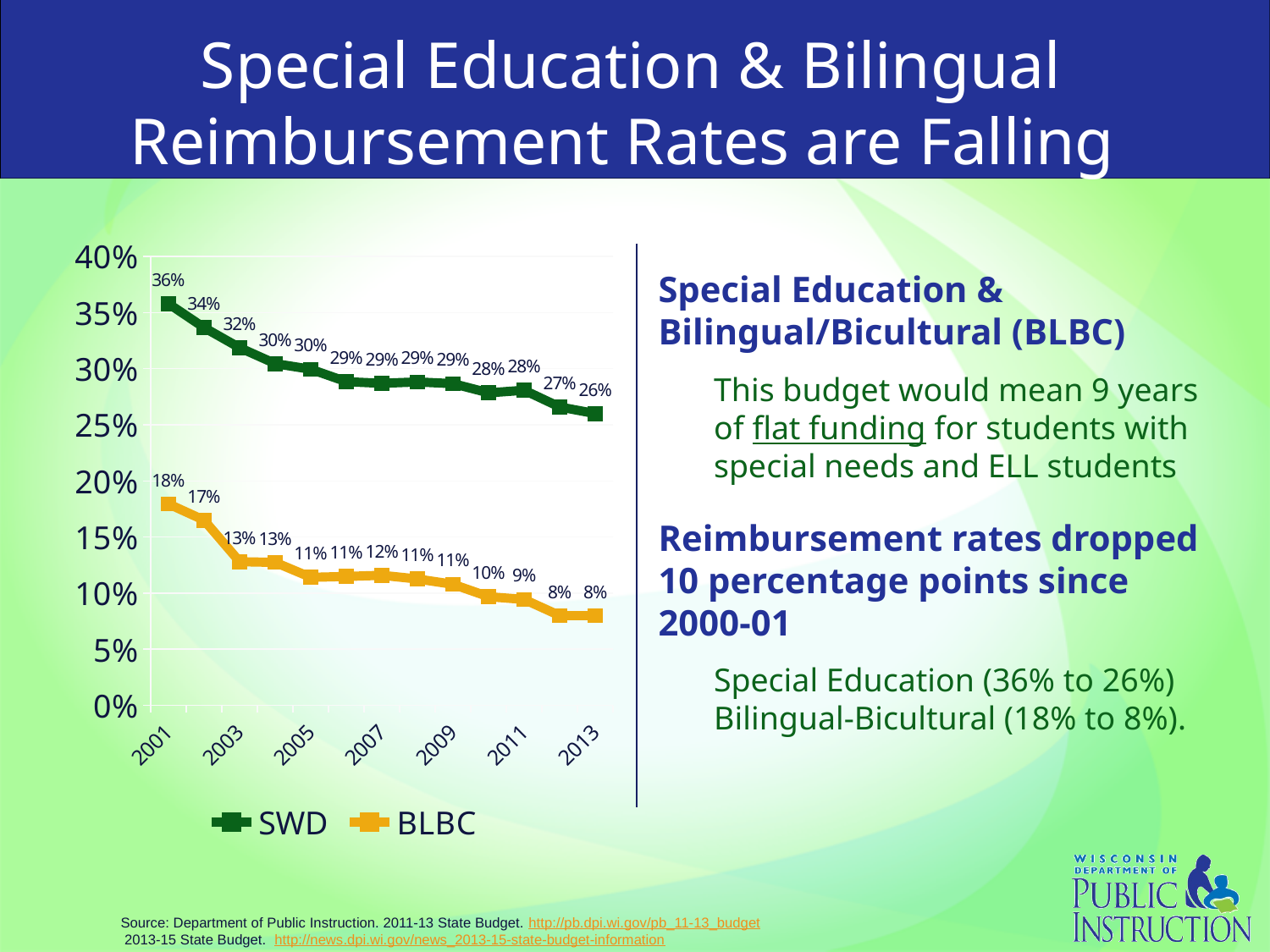
What is the difference between the SWD and BLBC rates in 2013? 18% Do the SWD values generally rise or fall from 2001 to 2013? Fall In which year is the BLBC rate lowest? 2012 and 2013 (both 8%) In which year is the SWD rate highest? 2001 What is the SWD value in 2007? 29% How many series does the chart legend list? 2 Which series has the higher value in 2005, SWD or BLBC? SWD What is the SWD reimbursement rate in 2001? 36% What is the BLBC value in 2003? 13% What type of chart is shown on the slide? Line chart What is the BLBC reimbursement rate in 2013? 8% By how many percentage points did the SWD rate fall from 2001 to 2013? 10